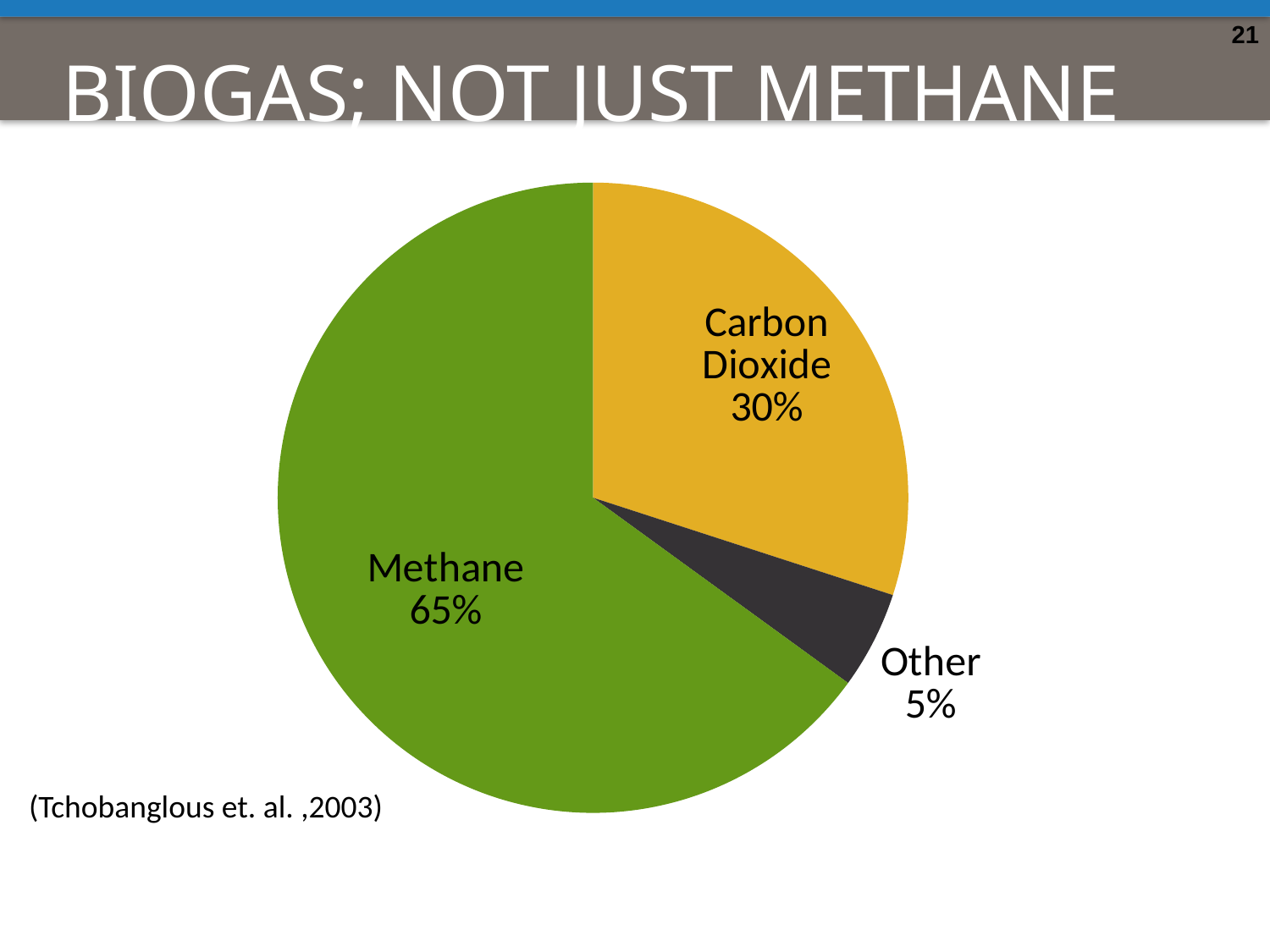
What percentage of biogas is Methane according to the pie chart? 65% What percentage of biogas is Carbon Dioxide according to the pie chart? 30% What colour is the Methane slice in the pie chart? green Which is larger, the Carbon Dioxide slice or the Other slice? Carbon Dioxide What is the difference in percentage points between the Carbon Dioxide and Other slices? 25 Which slice of the pie chart is the largest? Methane What is the difference in percentage points between the Methane and Carbon Dioxide slices? 35 What is the title of the slide containing the pie chart? BIOGAS; NOT JUST METHANE What type of chart is shown on the slide? pie chart What percentage of biogas is labelled Other in the pie chart? 5% How many slices does the pie chart have? 3 Which slice of the pie chart is the smallest? Other